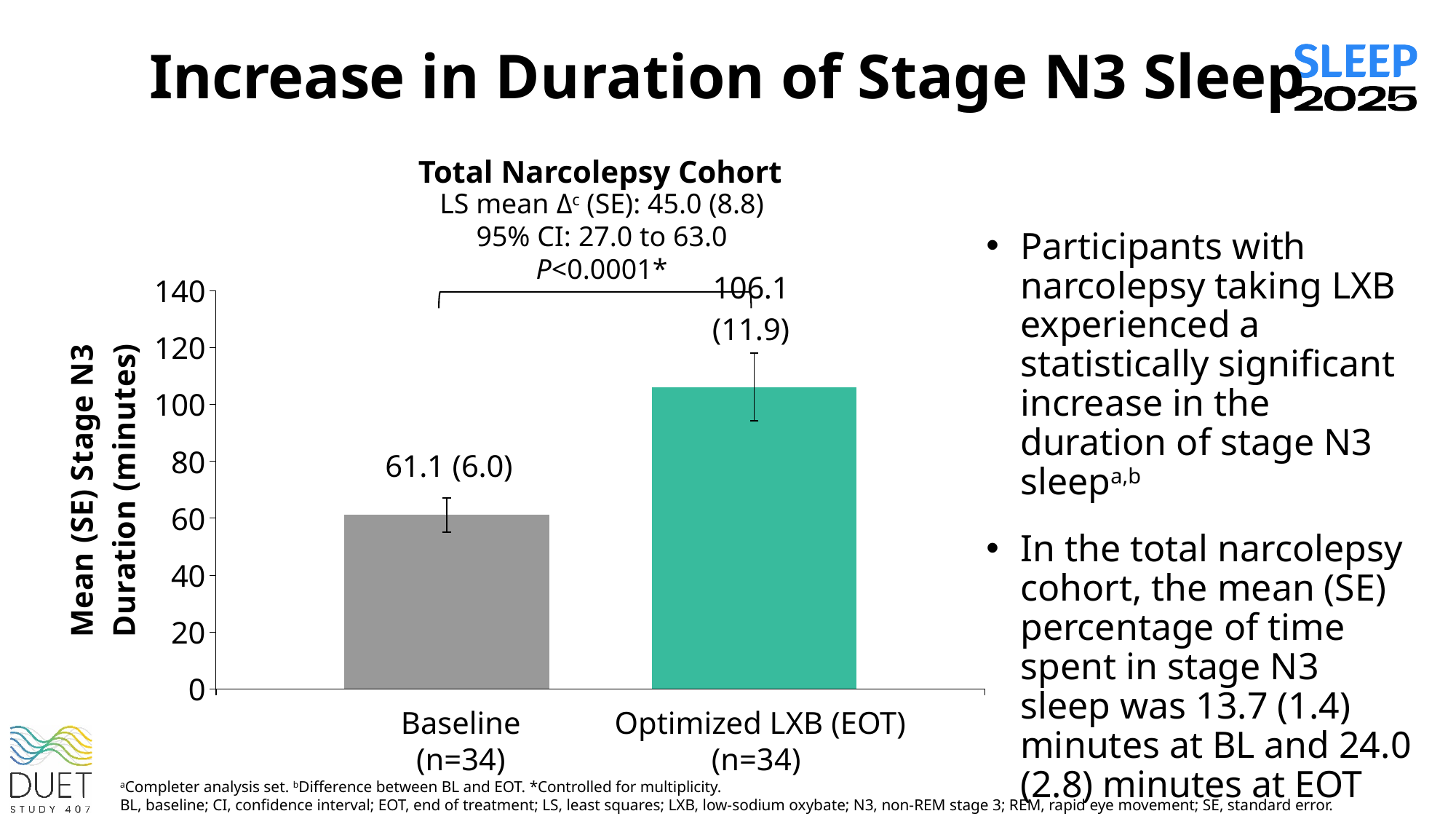
Is the mean stage N3 duration at Baseline greater or less than 80 minutes? less Do the values rise or fall from Baseline to Optimized LXB (EOT)? Rise What is the mean stage N3 sleep duration for Optimized LXB (EOT)? 106.1 (11.9) Which bar is higher, Baseline or Optimized LXB (EOT)? Optimized LXB (EOT) How many bars are shown in the chart? 2 What is the LS mean difference (SE) shown above the chart? 45.0 (8.8) What type of chart is shown on the slide? Bar chart What is the mean stage N3 sleep duration at Baseline? 61.1 (6.0) What is the y-axis label of the chart? Mean (SE) Stage N3 Duration (minutes) What is the difference in mean stage N3 duration between Optimized LXB (EOT) and Baseline, using the bar labels? 45.0 minutes Is the mean stage N3 duration for Optimized LXB (EOT) greater or less than 100 minutes? greater Which category has the lowest mean stage N3 sleep duration? Baseline